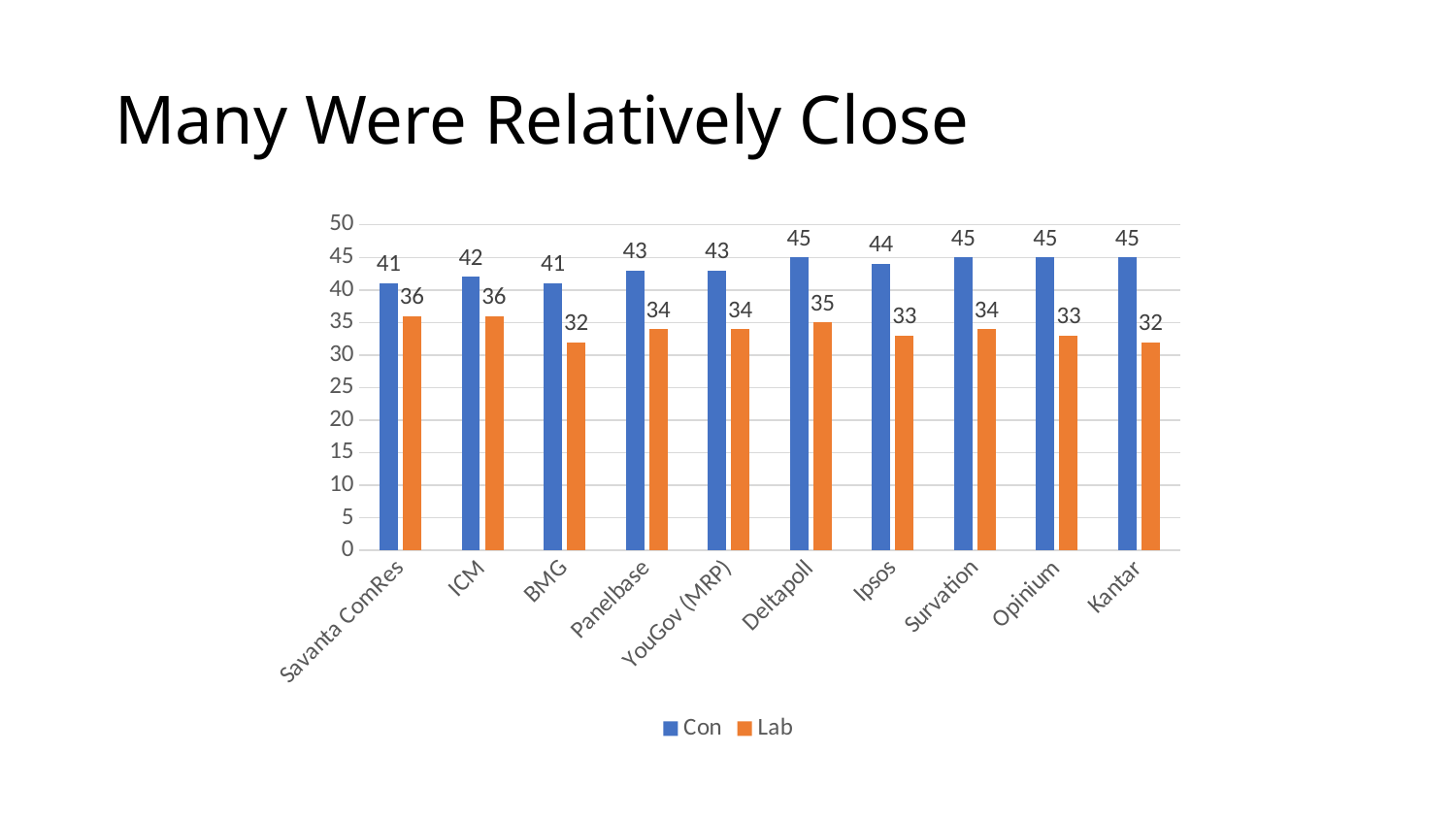
How many series does the legend list? 2 What is the Con value for ICM? 42 What is the Lab value for Kantar? 32 What is the Con value for Ipsos? 44 Which pollster has the highest Lab value? Savanta ComRes and ICM What is the difference between the Con and Lab values for Savanta ComRes? 5 What kind of chart is shown on the slide? Bar chart What is the Lab value for Deltapoll? 35 Which pollster has the lowest Con value? Savanta ComRes and BMG Which is larger, the Con value for Panelbase or the Con value for Deltapoll? Deltapoll What is the difference between the Con and Lab values for BMG? 9 How many pollsters are shown on the x axis? 10